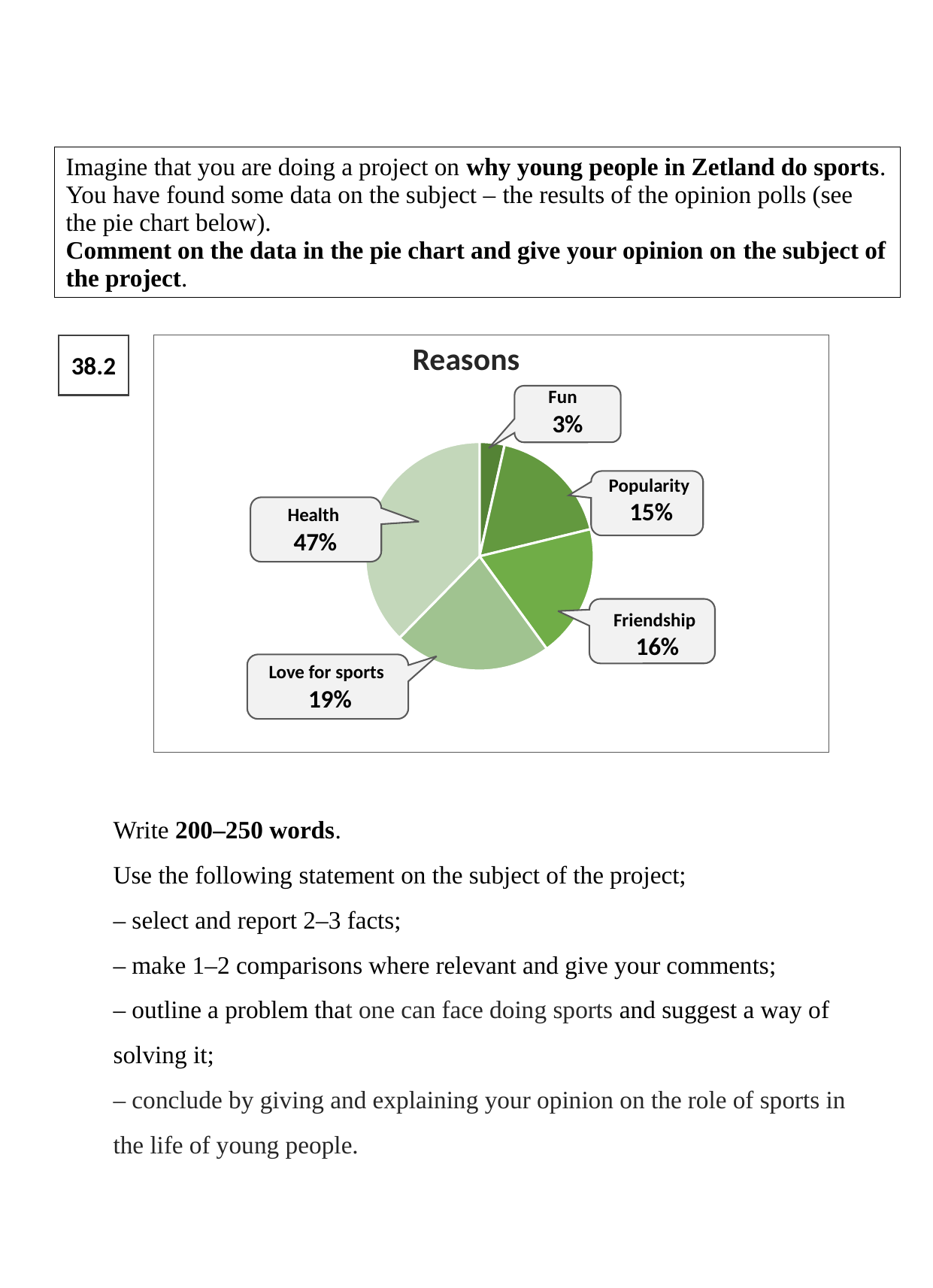
What is the value for Popularity in the pie chart? 15% What share does Love for sports have in the pie chart? 19% What kind of chart is shown on the slide? pie chart Which reason has the largest share of the pie chart? Health How many slices does the pie chart have? 5 Which is larger in the pie chart, Friendship or Fun? Friendship What percentage of the pie chart is Health? 47% What is the title of the pie chart? Reasons What is the difference in percentage points between Health and Love for sports? 28 What is the value for Friendship in the pie chart? 16% What is the value for Fun in the pie chart? 3% Which reason has the smallest share of the pie chart? Fun